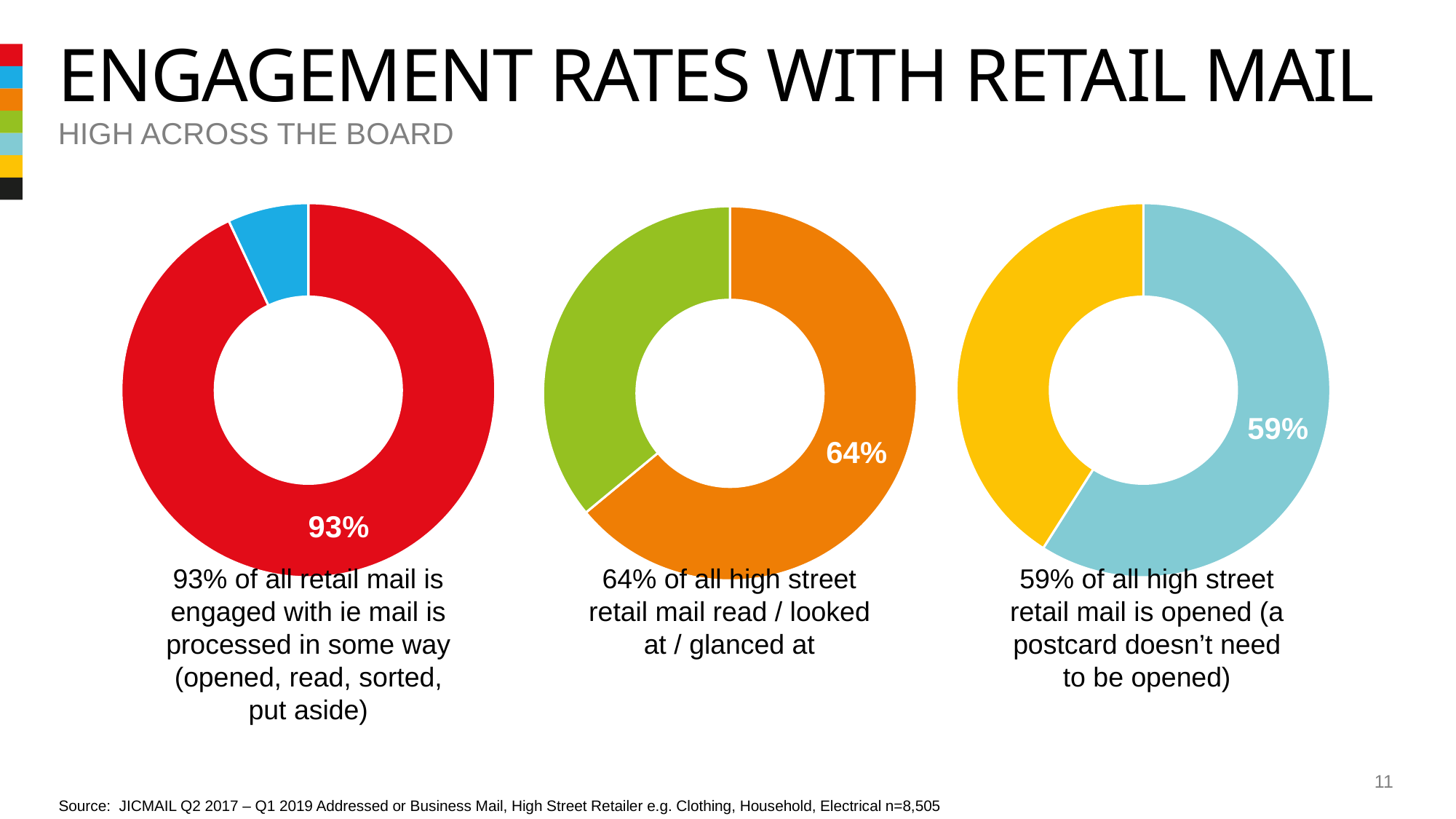
What is the difference between the labelled value in the middle chart (64%) and the labelled value in the right chart (59%)? 5 percentage points What kind of chart is used for the three charts on this slide? Doughnut (pie) chart Which is larger: the labelled slice in the middle chart or the labelled slice in the right chart? The middle chart's slice (64%) Which of the three doughnut charts shows the lowest labelled percentage? The right chart (59%) What is the difference between the labelled value in the left chart (93%) and the labelled value in the middle chart (64%)? 29 percentage points In the middle doughnut chart, what percentage is printed on the orange slice? 64% How many doughnut charts are shown on the slide? 3 In the middle doughnut chart, what share of the whole does the orange slice represent? 64% How many slices does the left doughnut chart have? 2 In the right doughnut chart, what percentage is printed on the light blue slice? 59% Which of the three doughnut charts shows the highest labelled percentage? The left chart (93%) In the left doughnut chart, what percentage is printed on the large red slice? 93%